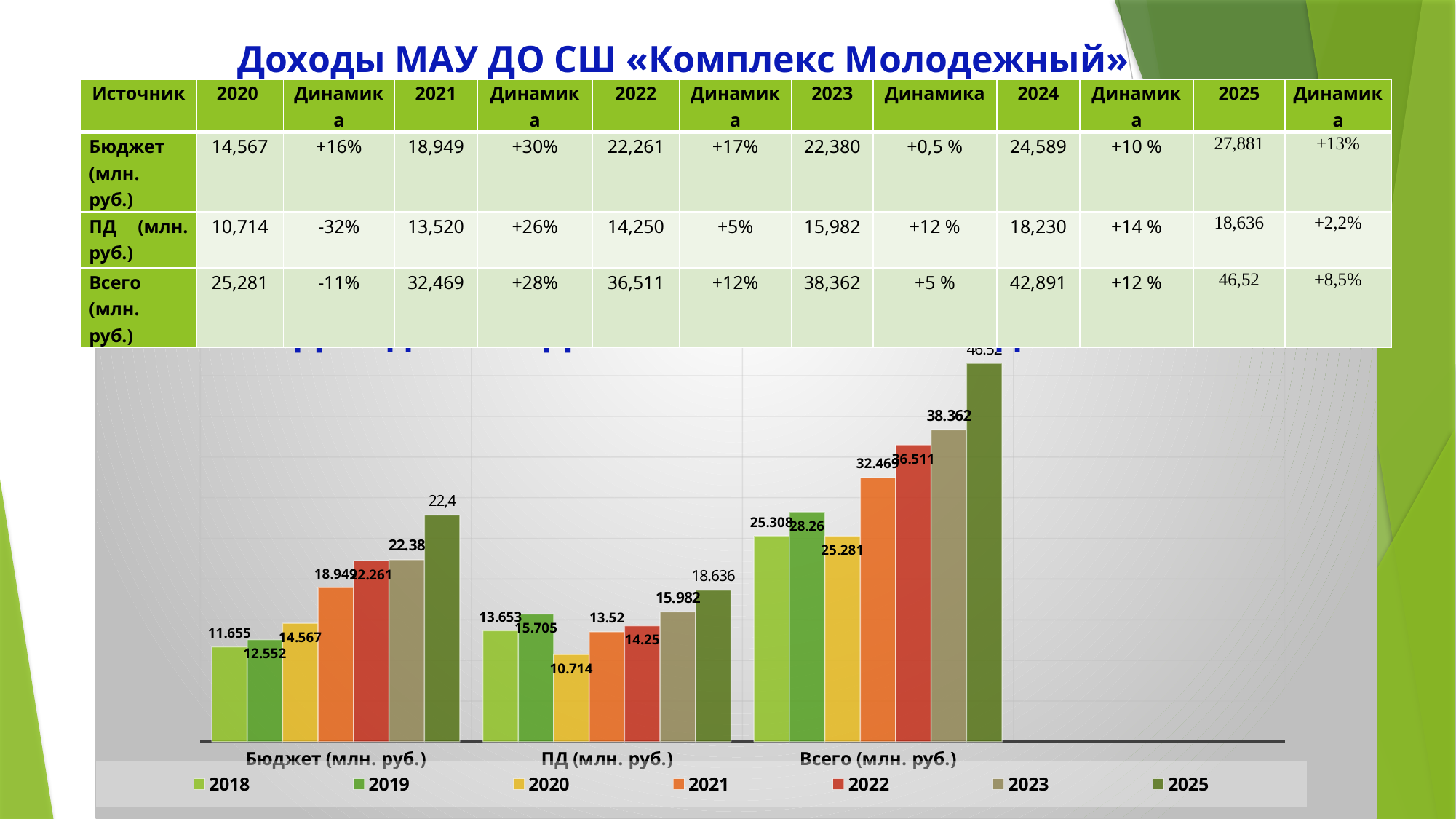
In the chart, what is the difference between the 2022 and 2021 values in the Всего (млн. руб.) category? 4.042 In the chart, what is the value for 2018 in the ПД (млн. руб.) category? 13.653 How many categories are shown on the x axis of the chart? 3 What kind of chart is shown on the slide? bar chart How many series does the chart legend list? 7 In the chart, what is the value for 2023 in the Всего (млн. руб.) category? 38.362 In the chart, what is the value for 2021 in the ПД (млн. руб.) category? 13.52 In the chart, which year has the lowest value in the ПД (млн. руб.) category? 2020 Which year is shown in the legend immediately after 2023? 2025 In the chart, what is the value for 2020 in the Бюджет (млн. руб.) category? 14.567 In the chart, which is larger in the Бюджет (млн. руб.) category: the 2021 value or the 2022 value? 2022 In the chart, which year has the highest value in the Всего (млн. руб.) category? 2025